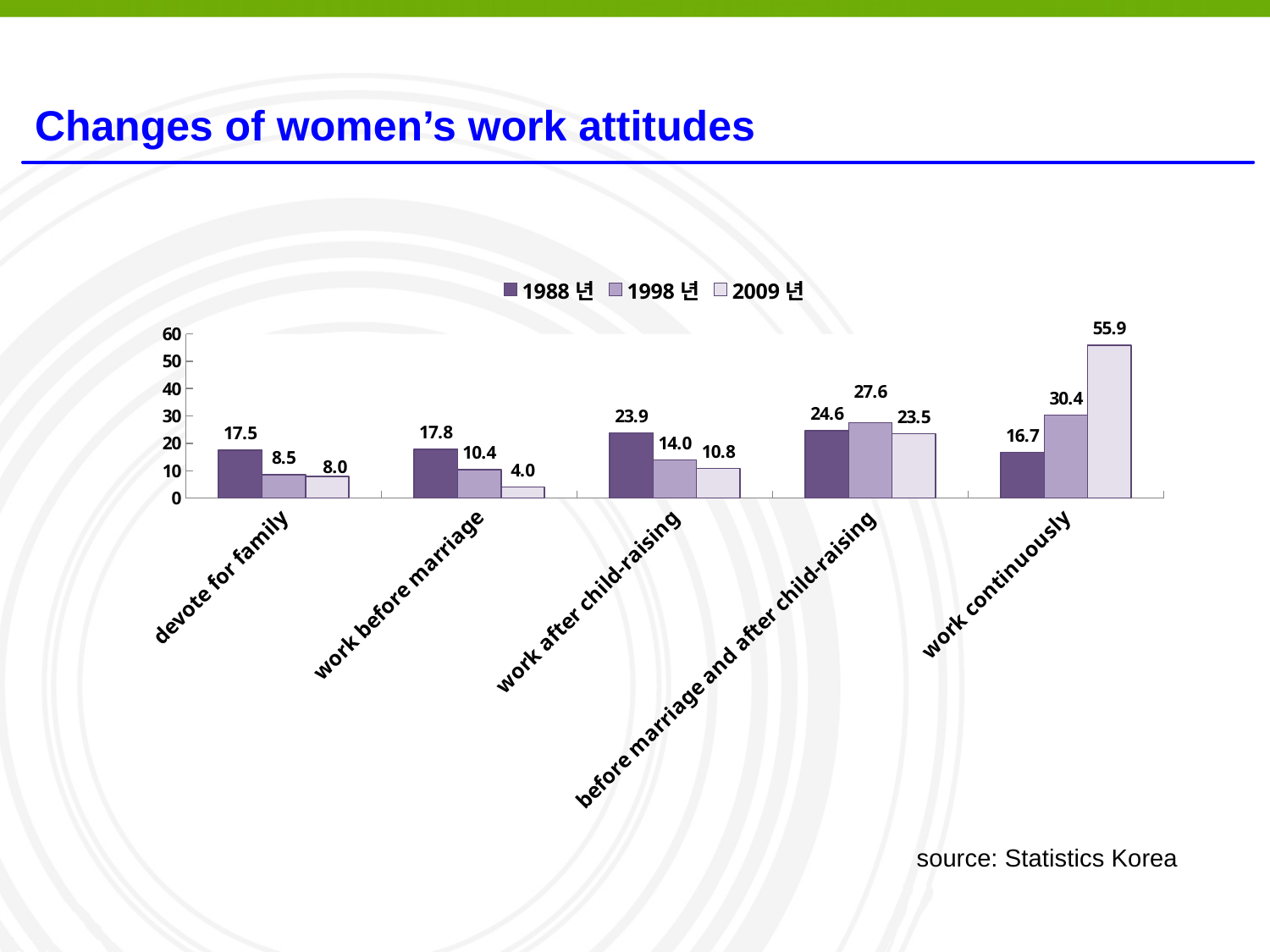
What is the value for 'work continuously' in the 2009 년 series? 55.9 What kind of chart is shown on the slide? bar chart Is the 2009 년 value for 'work continuously' greater or less than 50? greater What is the value for 'work before marriage' in the 2009 년 series? 4.0 Which is larger for 'work after child-raising': the 1988 년 value or the 1998 년 value? 1988 년 How many series does the legend list? 3 How many categories are shown on the x axis? 5 What is the value for 'before marriage and after child-raising' in the 1998 년 series? 27.6 What is the difference between the 2009 년 and 1988 년 values for 'work continuously'? 39.2 What is the value for 'devote for family' in the 1988 년 series? 17.5 Which category has the lowest value in the 2009 년 series? work before marriage Which category has the highest value in the 2009 년 series? work continuously